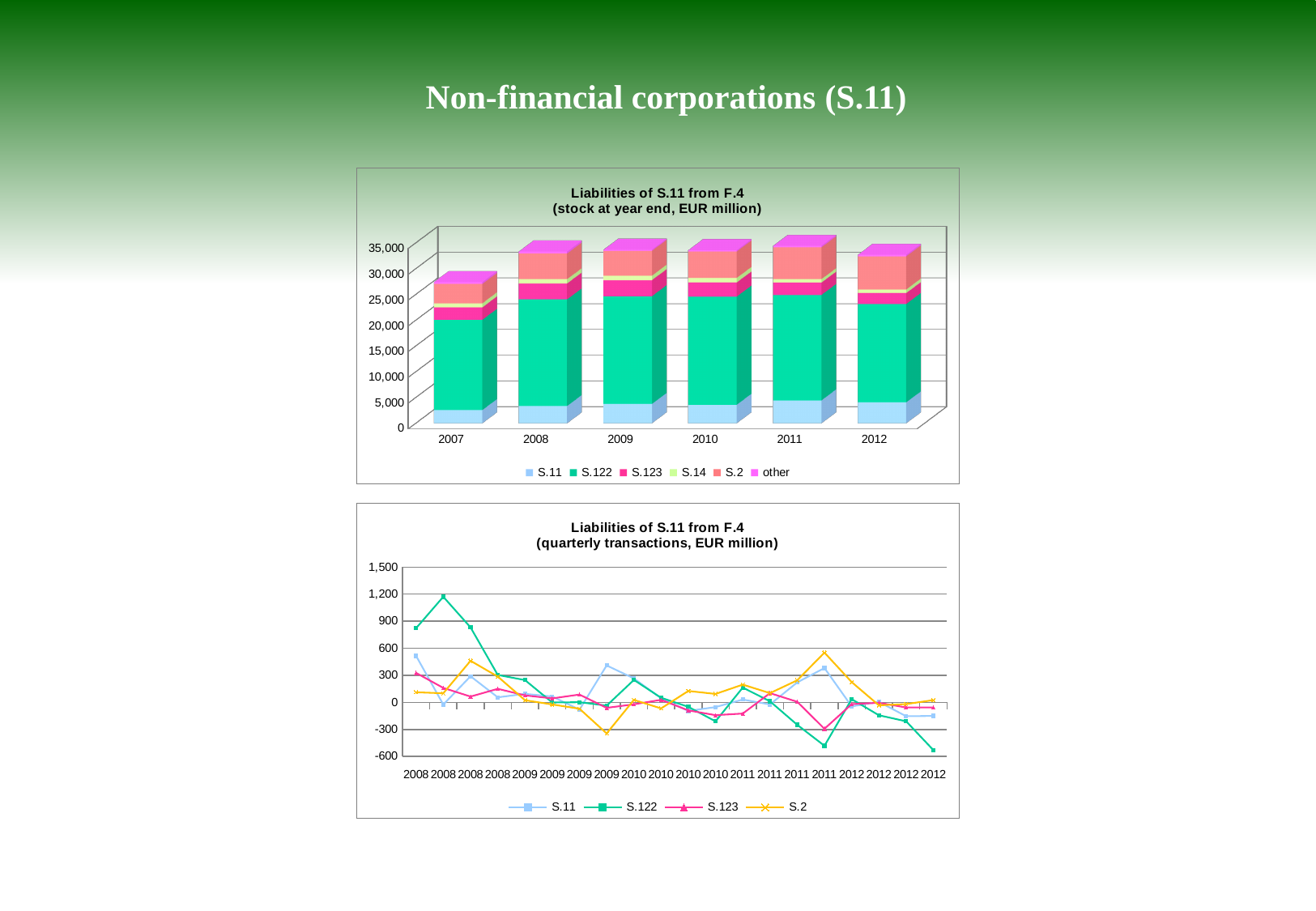
In the top chart (stock at year end), how many series does the legend list? 6 In the bottom chart (quarterly transactions), is the value of S.122 at the first 2008 point greater or less than 600? greater In the top chart (stock at year end), which year has the lowest total stacked bar? 2007 What kind of chart is the top chart titled "Liabilities of S.11 from F.4 (stock at year end, EUR million)"? stacked bar chart In the bottom chart (quarterly transactions), is the value of S.122 at the last 2012 point greater or less than -300? less In the top chart (stock at year end), how many years are shown on the x axis? 6 In the top chart (stock at year end), is the total for 2007 greater or less than 35,000? less In the bottom chart (quarterly transactions), which series reaches the highest value on the chart? S.122 What kind of chart is the bottom chart titled "Liabilities of S.11 from F.4 (quarterly transactions, EUR million)"? line chart In the bottom chart (quarterly transactions), how many series does the legend list? 4 In the top chart (stock at year end), which series forms the largest segment of each bar? S.122